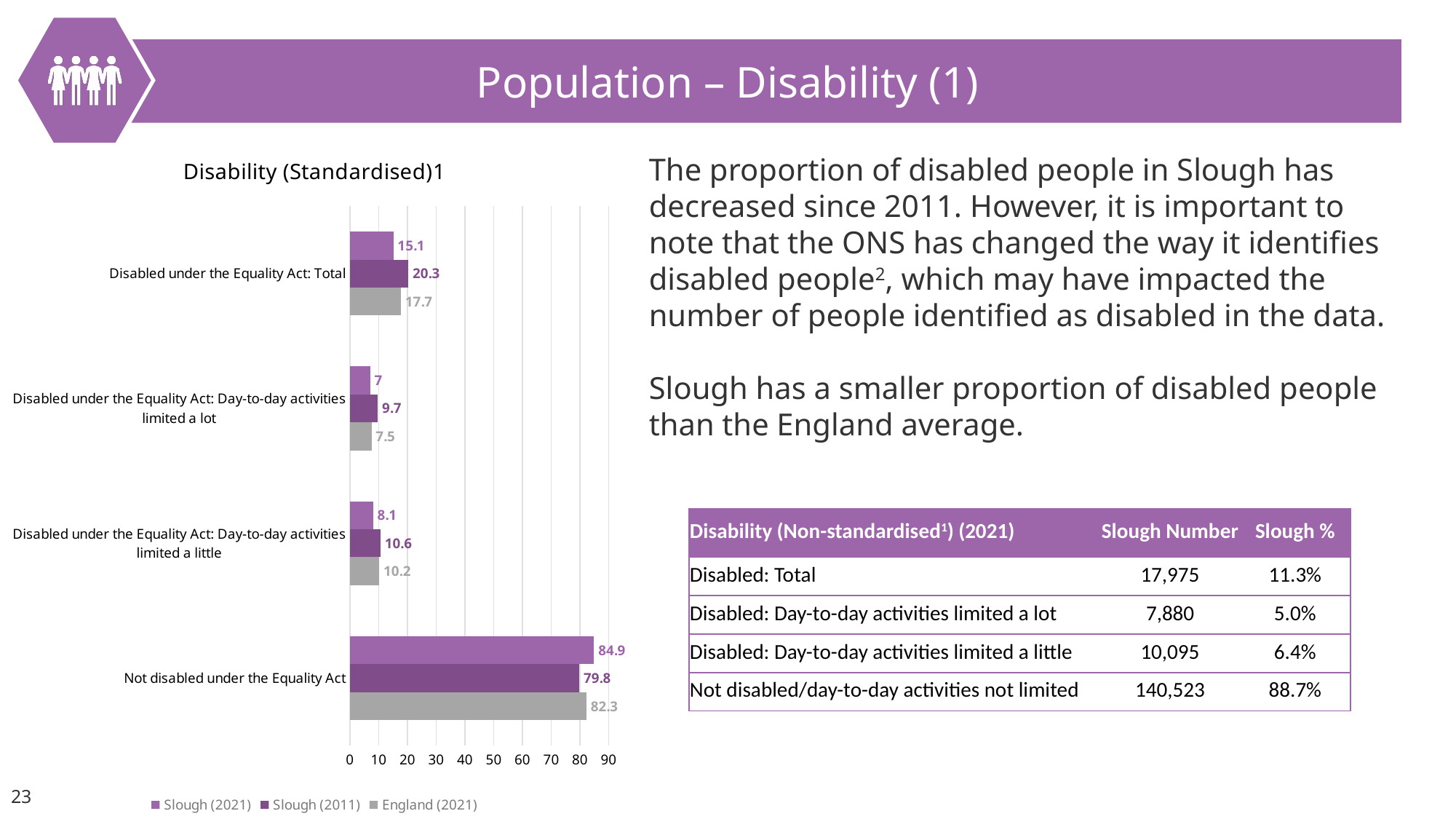
For 'Not disabled under the Equality Act', which is larger: the Slough (2021) value or the England (2021) value? Slough (2021) Which category has the highest Slough (2021) value? Not disabled under the Equality Act How many categories are shown on the chart? 4 What is the title of the chart? Disability (Standardised)1 What is the Slough (2021) value for 'Disabled under the Equality Act: Total'? 15.1 How many series does the chart legend list? 3 Which category has the lowest England (2021) value? Disabled under the Equality Act: Day-to-day activities limited a lot What is the Slough (2021) value for 'Disabled under the Equality Act: Day-to-day activities limited a lot'? 7 What is the England (2021) value for 'Disabled under the Equality Act: Day-to-day activities limited a little'? 10.2 What kind of chart is shown on the slide? Bar chart What is the Slough (2011) value for 'Not disabled under the Equality Act'? 79.8 What is the difference between the Slough (2011) and Slough (2021) values for 'Disabled under the Equality Act: Total'? 5.2